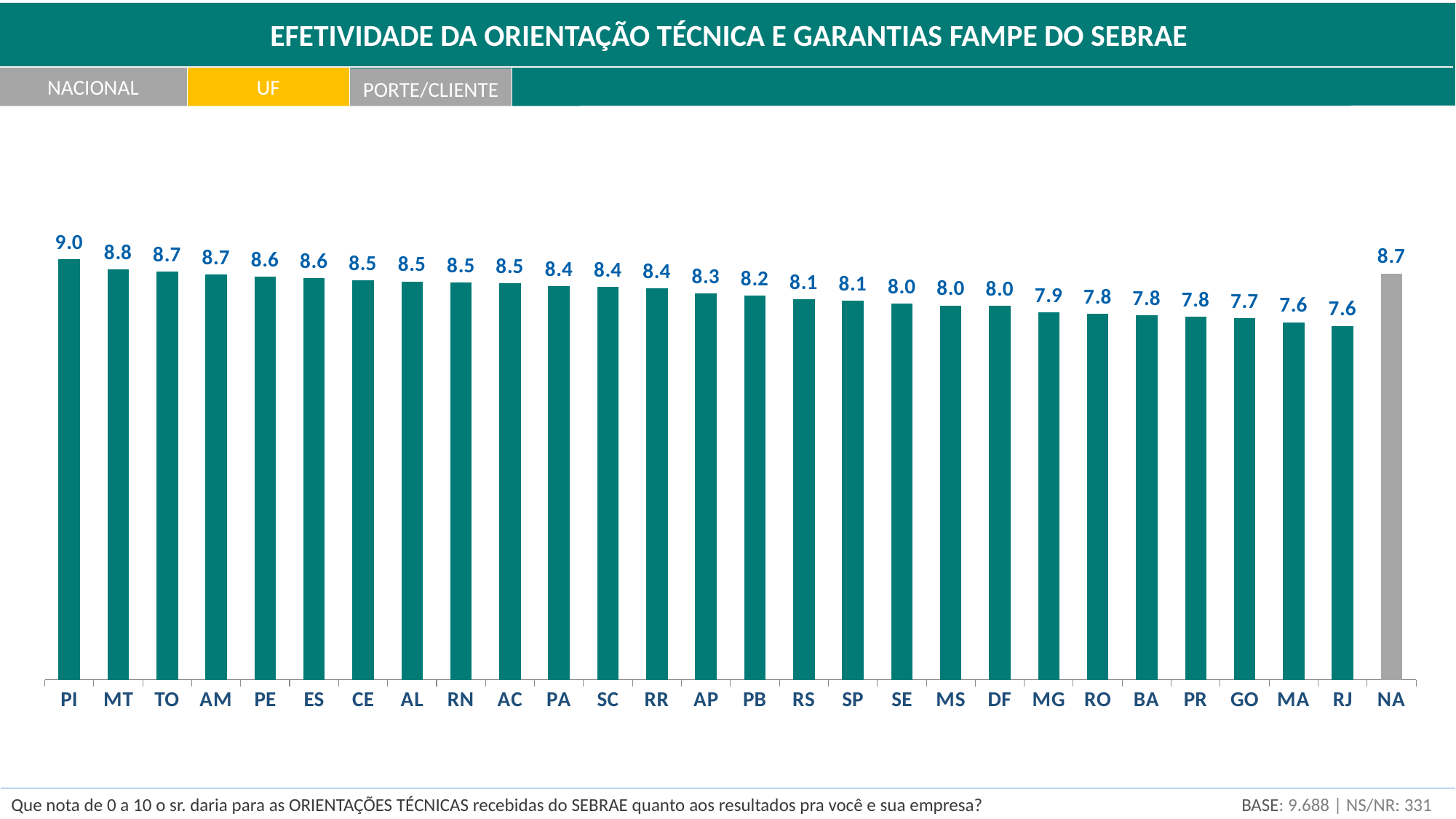
What kind of chart is shown on the slide? bar chart What is the difference between the values for MT and MG? 0.9 What is the difference between the values for PI and RJ? 1.4 What is the value for NA? 8.7 What is the value for GO? 7.7 Which category has the highest value? PI Which is larger, the value for AP or the value for BA? AP What is the value for SP? 8.1 What is the value for PI? 9.0 Which tab is highlighted in yellow above the chart? UF How many categories are shown on the x axis? 28 Which is larger, the value for NA or the value for DF? NA